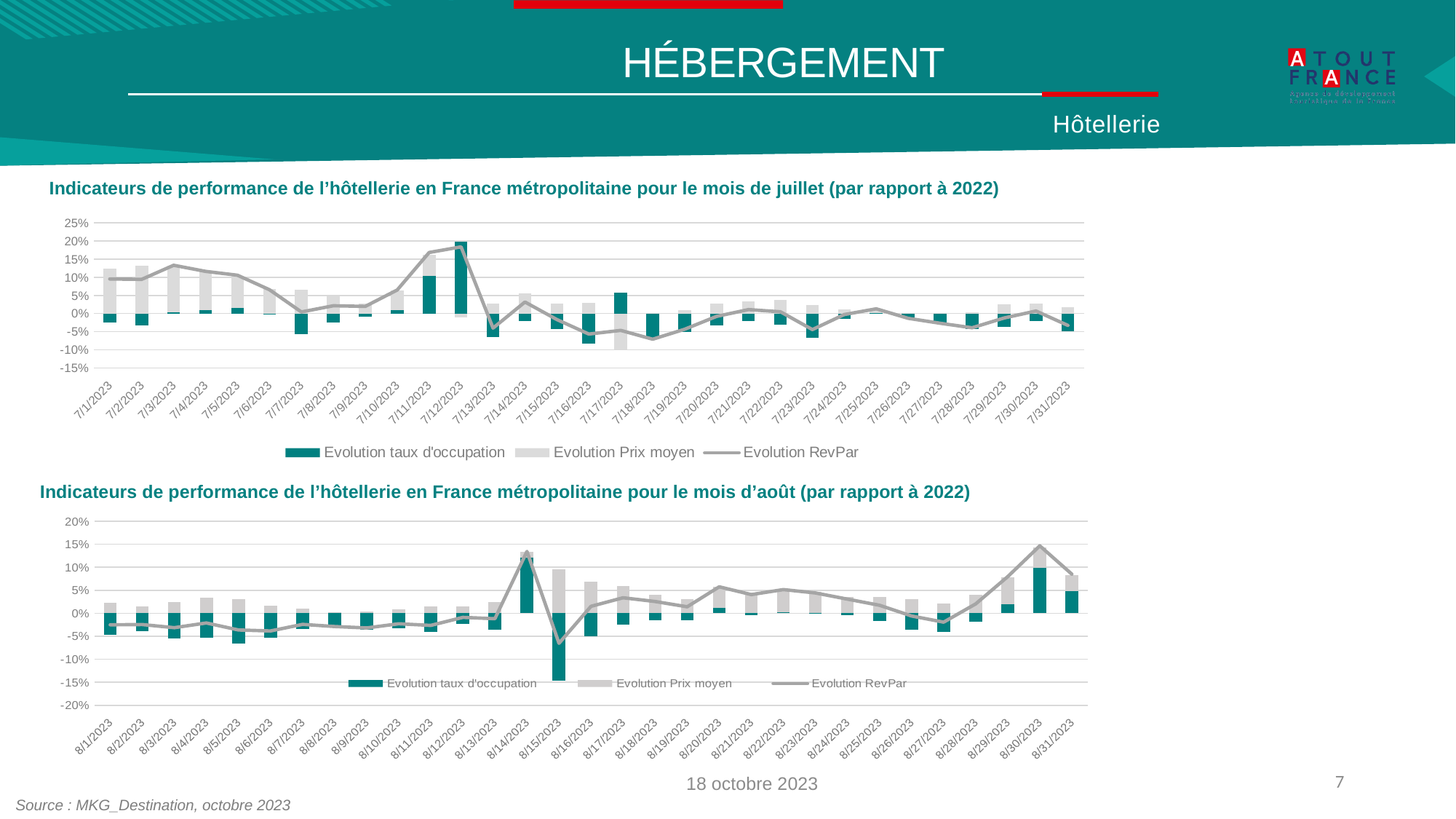
In the July chart (top), is the Evolution taux d'occupation value for 7/12/2023 greater or less than 15%? greater In the July chart (top), which series is drawn as a line rather than bars? Evolution RevPar In the July chart (top), on which date is the Evolution Prix moyen bar lowest? 7/17/2023 In the August chart (bottom), on which date does the Evolution RevPar line reach its lowest point? 8/15/2023 In the July chart (top), how many dates are plotted on the x axis? 31 In the July chart (top), is the Evolution RevPar value for 7/12/2023 greater or less than 15%? greater In the August chart (bottom), is the Evolution RevPar value for 8/30/2023 greater or less than 10%? greater In the July chart (top), on which date is the Evolution taux d'occupation bar highest? 7/12/2023 In the July chart (top), how many series does the legend list? 3 In the August chart (bottom), on which date is the Evolution taux d'occupation bar lowest? 8/15/2023 In the August chart (bottom), what kind of chart is used? Combined bar and line chart